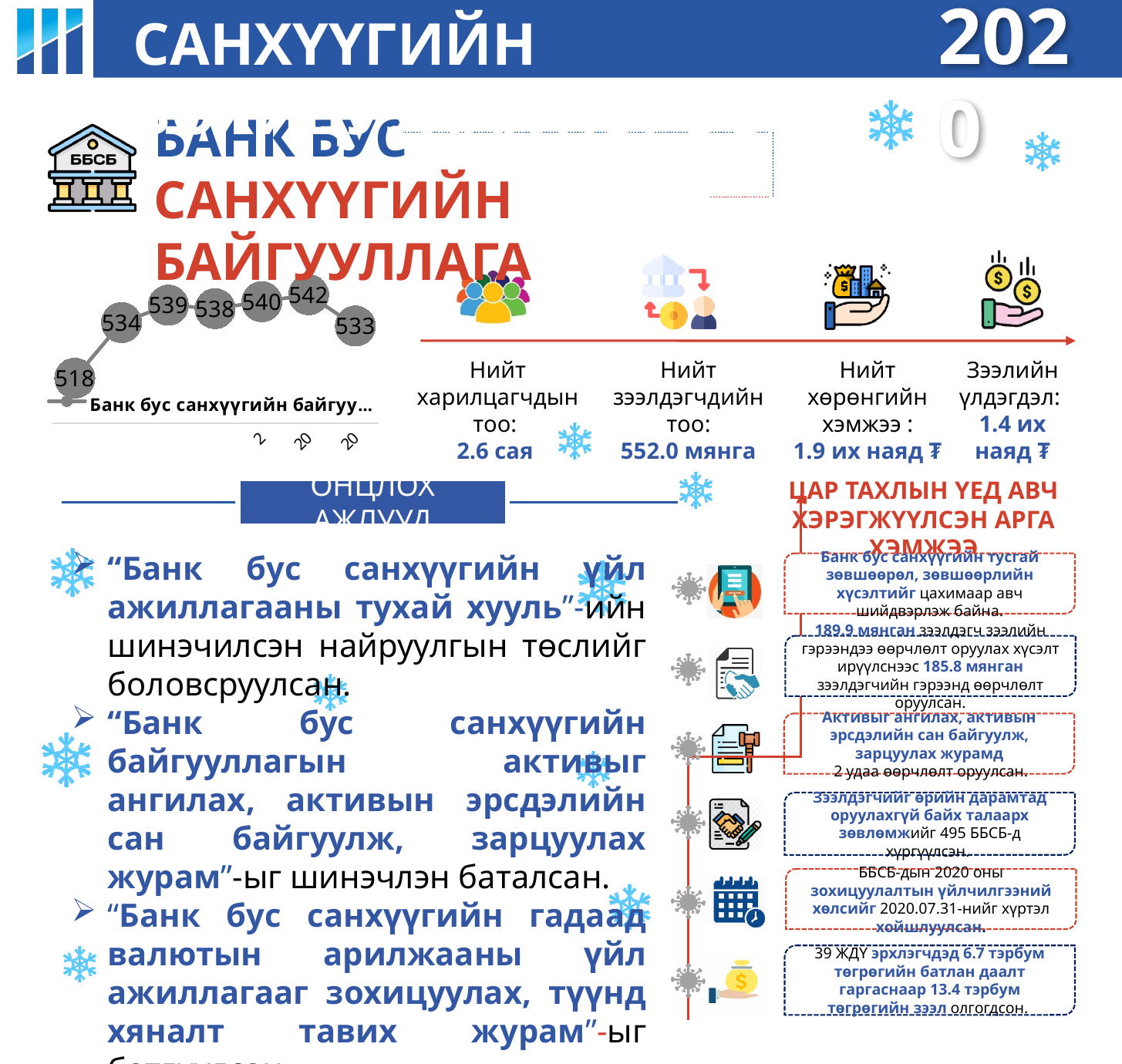
Does the line chart rise or fall between the last two data points? fall What is the difference between the first and last data points on the line chart? 15 How many series does the legend of the line chart list? 1 What is the lowest value shown on the line chart? 518 Which is larger on the line chart: the second data point or the last data point? the second data point (534) What type of chart is shown on the slide? line chart What is the value of the first data point on the line chart? 518 What is the highest value shown on the line chart? 542 How many data points are plotted on the line chart? 7 What is the value of the last data point on the line chart? 533 Does the line chart rise or fall between the first and second data points? rise What is the difference between the highest and lowest values on the line chart? 24